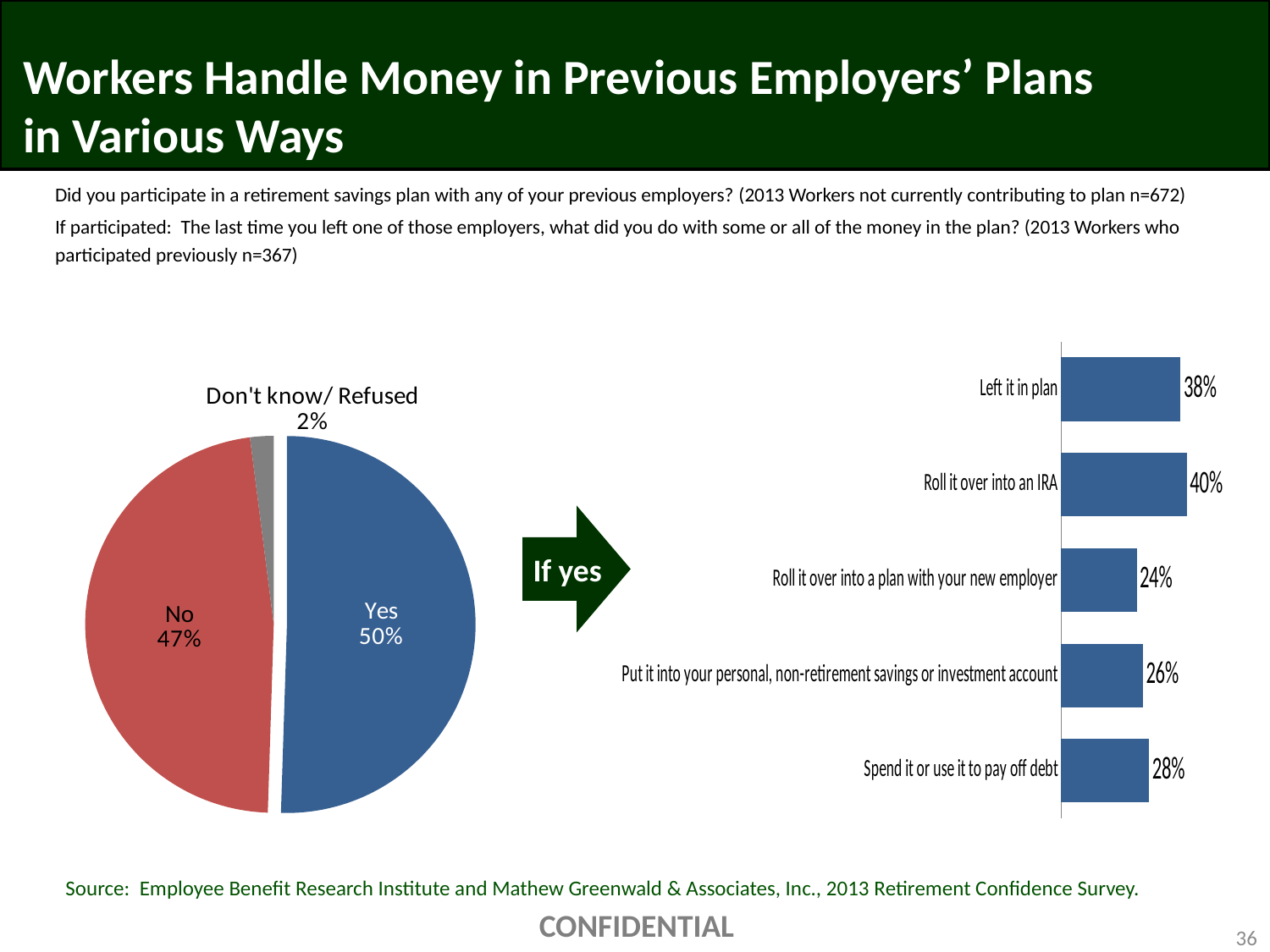
In the bar chart on the right, what is the value for Roll it over into an IRA? 40% In the bar chart on the right, which is larger: Put it into your personal, non-retirement savings or investment account, or Roll it over into a plan with your new employer? Put it into your personal, non-retirement savings or investment account In the pie chart on the left, what share of respondents answered No? 47% In the bar chart on the right, what is the difference between Roll it over into an IRA and Left it in plan? 2% In the bar chart on the right, what is the value for Spend it or use it to pay off debt? 28% What type of chart is shown on the right side of the slide? Bar chart In the pie chart on the left, what share of respondents answered Yes? 50% In the bar chart on the right, which option has the lowest value? Roll it over into a plan with your new employer In the bar chart on the right, which option has the highest value? Roll it over into an IRA In the pie chart on the left, what share of respondents answered Don't know/ Refused? 2% In the pie chart on the left, which response has the smallest slice? Don't know/ Refused In the pie chart on the left, how many slices are there? 3